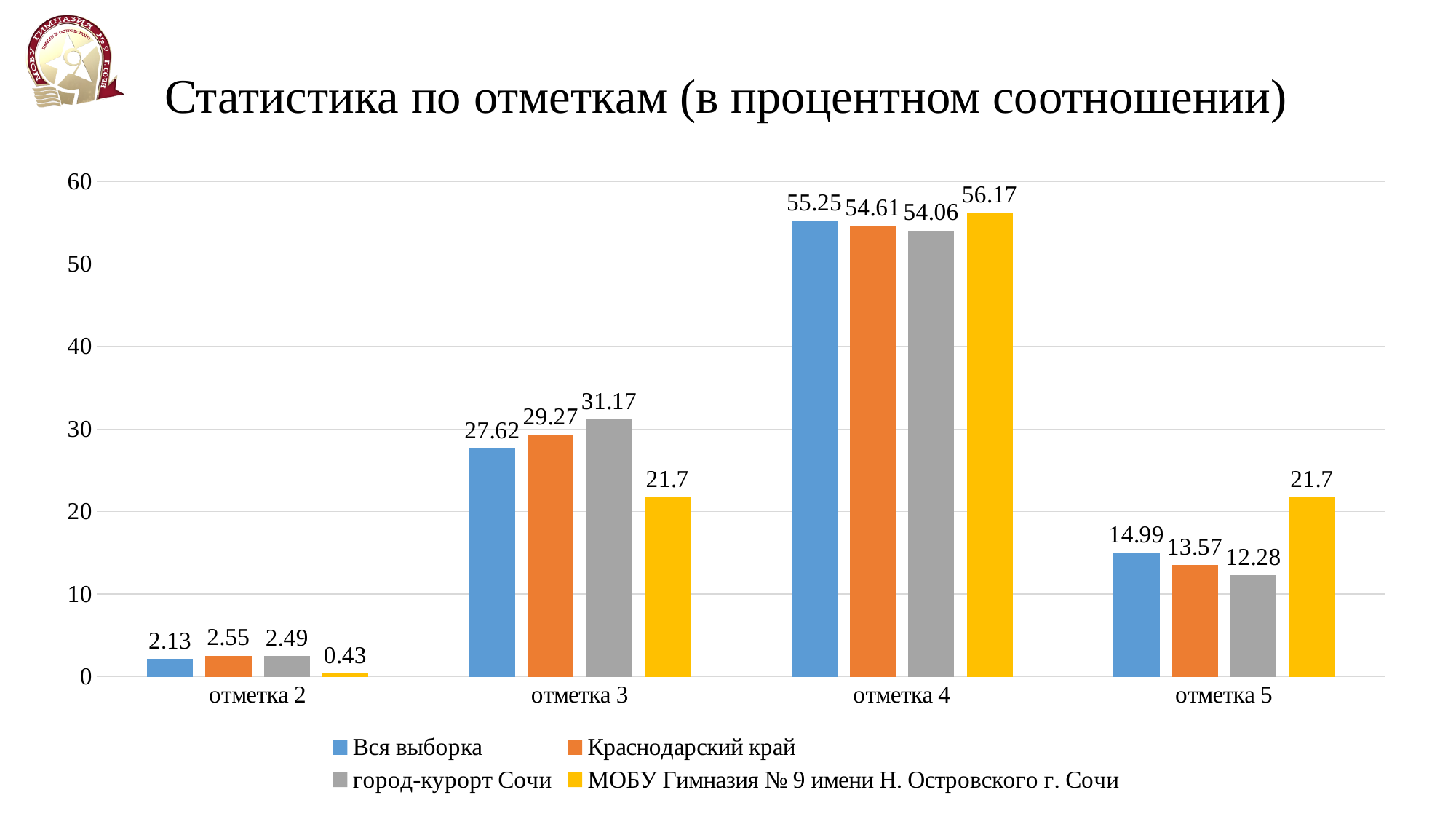
What is the value for город-курорт Сочи at отметка 3? 31.17 What is the title of the chart? Статистика по отметкам (в процентном соотношении) What kind of chart is shown on the slide? Bar chart What is the value for МОБУ Гимназия № 9 имени Н. Островского г. Сочи at отметка 2? 0.43 What is the value for Вся выборка at отметка 4? 55.25 How many categories are shown on the x axis? 4 What is the difference between the values for Вся выборка and город-курорт Сочи at отметка 5? 2.71 What is the value for Краснодарский край at отметка 5? 13.57 Which is larger at отметка 3: the value for Краснодарский край or the value for Вся выборка? Краснодарский край Which series has the lowest value at отметка 3? МОБУ Гимназия № 9 имени Н. Островского г. Сочи Which series has the highest value at отметка 4? МОБУ Гимназия № 9 имени Н. Островского г. Сочи How many series does the legend list? 4